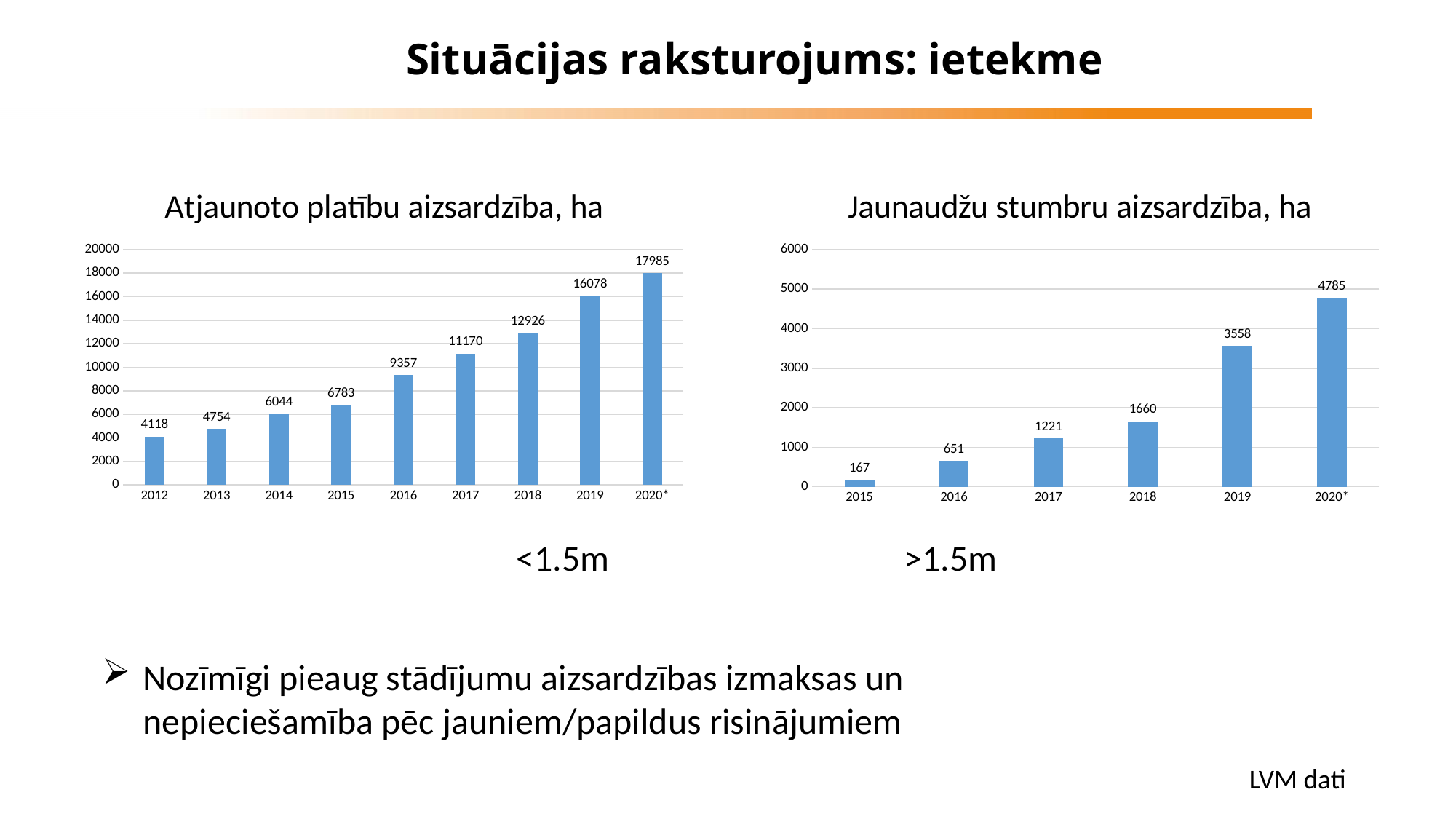
In the chart 'Atjaunoto platību aizsardzība, ha', do the values rise or fall from 2012 to 2020*? rise In the chart 'Atjaunoto platību aizsardzība, ha', which year has the lowest value? 2012 In the chart 'Jaunaudžu stumbru aizsardzība, ha', how many years are shown on the x axis? 6 In the chart 'Jaunaudžu stumbru aizsardzība, ha', which year has the lowest value? 2015 In the chart 'Jaunaudžu stumbru aizsardzība, ha', which is larger, the value for 2017 or the value for 2016? 2017 In the chart 'Atjaunoto platību aizsardzība, ha', which year has the highest value? 2020* In the chart 'Jaunaudžu stumbru aizsardzība, ha', what is the difference between the values for 2020* and 2019? 1227 In the chart 'Jaunaudžu stumbru aizsardzība, ha', what is the value for 2018? 1660 In the chart 'Atjaunoto platību aizsardzība, ha', what is the difference between the values for 2019 and 2018? 3152 In the chart 'Atjaunoto platību aizsardzība, ha', what is the value for 2016? 9357 In the chart 'Atjaunoto platību aizsardzība, ha', how many years are shown on the x axis? 9 What kind of chart is the chart 'Jaunaudžu stumbru aizsardzība, ha'? bar chart